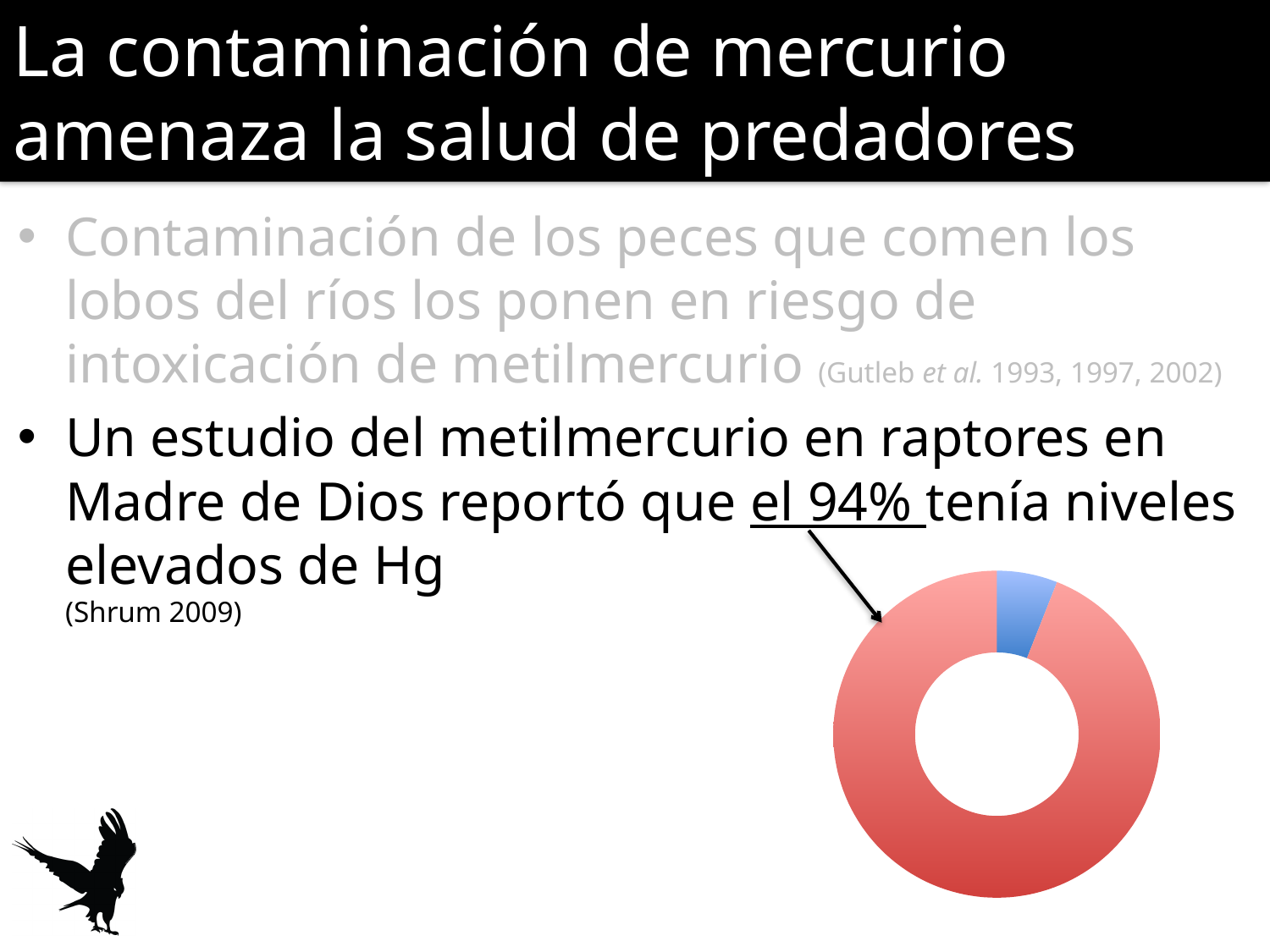
What two colours are used for the slices of the doughnut chart? red and blue Which colour slice is the largest in the doughnut chart? red Which colour slice is the smallest in the doughnut chart? blue Is the share of the blue slice in the doughnut chart greater or less than 25%? less How many slices does the doughnut chart have? 2 What percentage does the slide text link to the doughnut chart with an arrow? 94% Which slice of the doughnut chart is larger, the red one or the blue one? the red one Does the doughnut chart display a legend? No What share of the doughnut chart does the red slice represent, according to the percentage the arrow points from? 94% Is the share of the red slice in the doughnut chart greater or less than 50%? greater What kind of chart is shown on the slide? doughnut (pie) chart